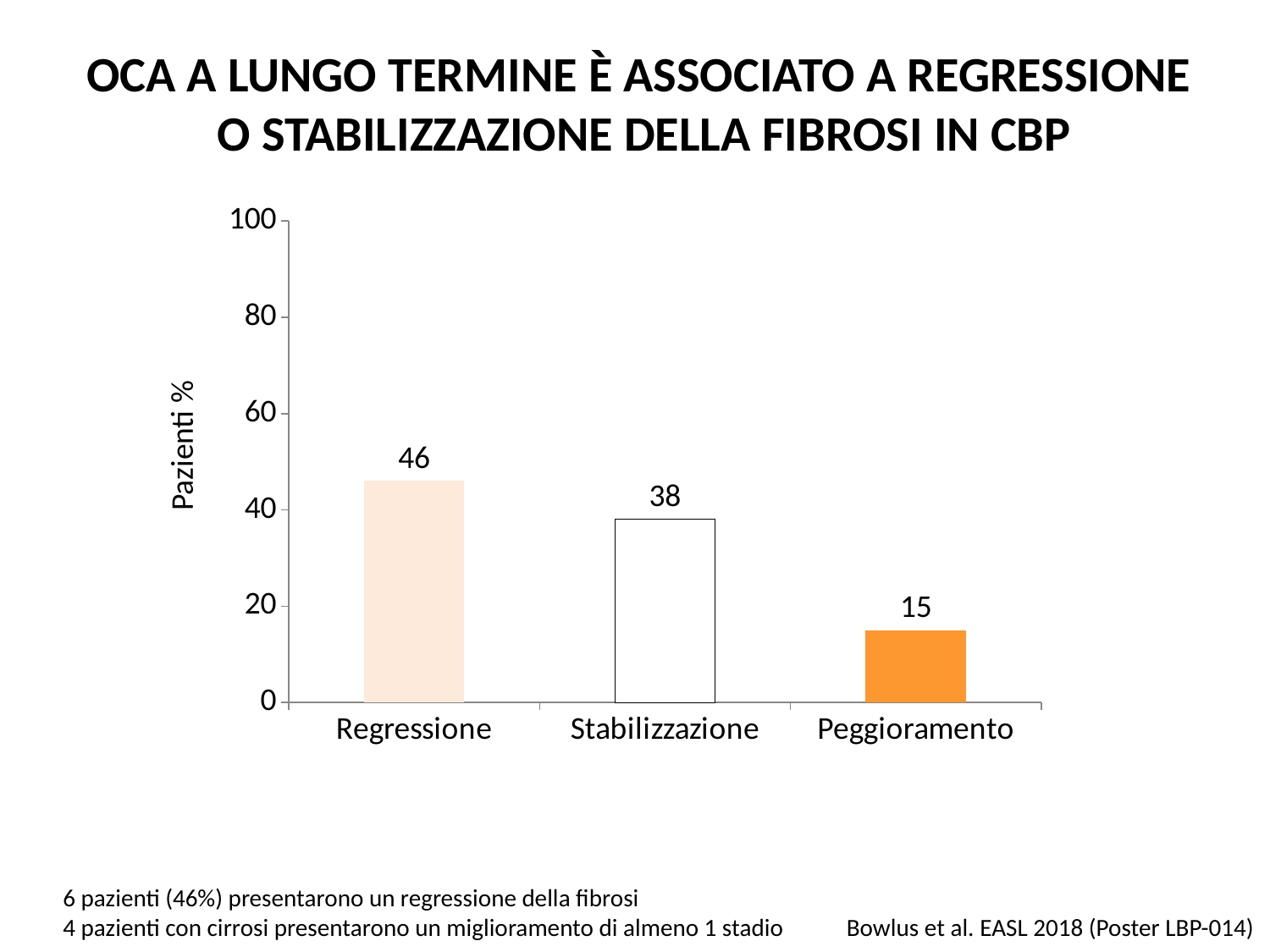
Which category has the highest value? Regressione What is the label of the y axis? Pazienti % What is the difference between the values for Stabilizzazione and Peggioramento? 23 Is the value for Regressione greater or less than 40? greater Which is larger, the value for Stabilizzazione or the value for Peggioramento? Stabilizzazione What is the value for Regressione? 46 What kind of chart is shown on the slide? bar chart What is the value for Stabilizzazione? 38 How many categories are shown on the x axis? 3 What is the difference between the values for Regressione and Stabilizzazione? 8 Which category has the lowest value? Peggioramento What is the value for Peggioramento? 15